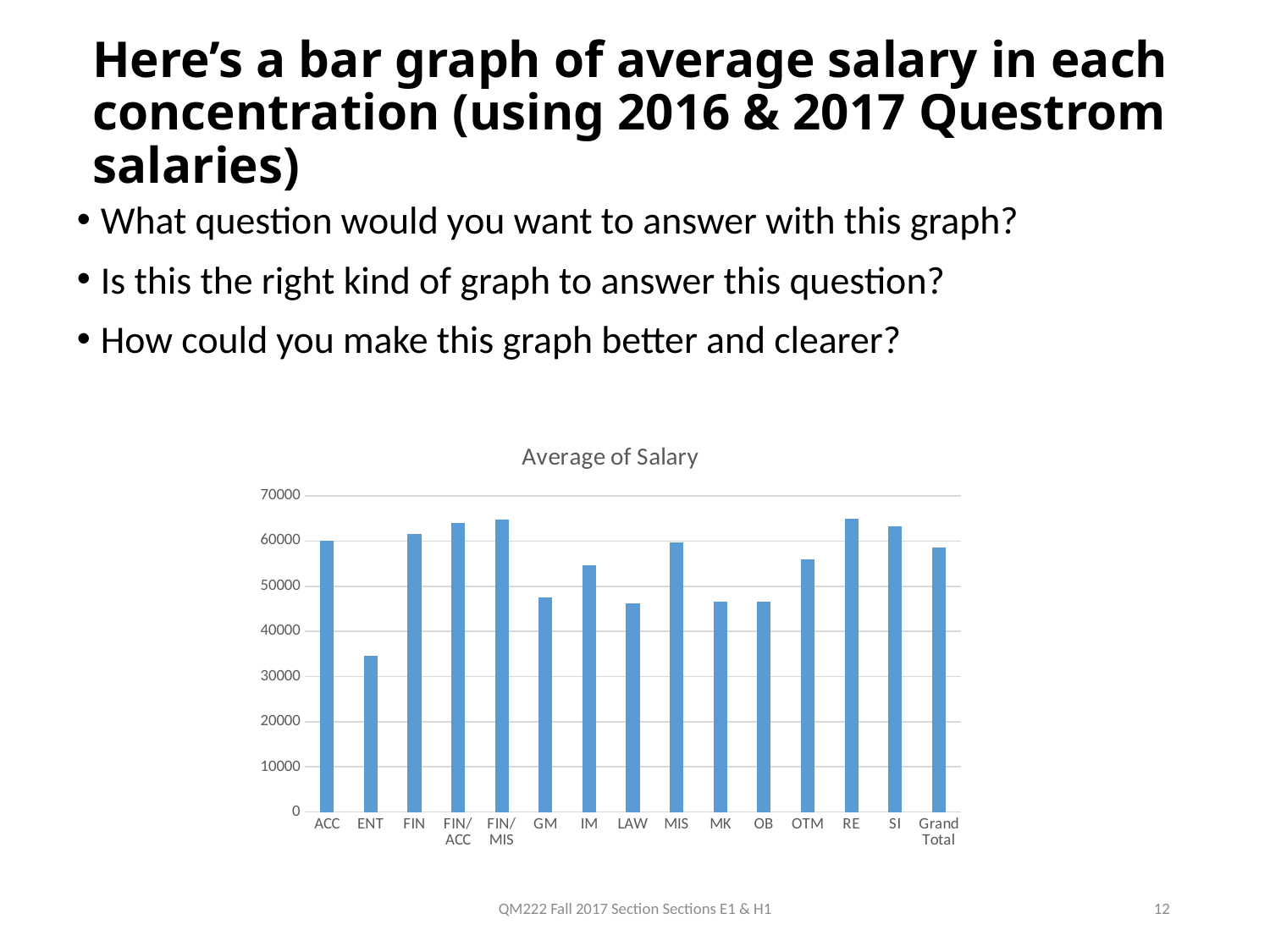
Which has a higher average salary, FIN or GM? FIN Is the value for RE greater or less than 60000? greater What kind of chart is shown on the slide? bar chart What is the title of the chart? Average of Salary Which has a higher average salary, ENT or LAW? LAW Is the value for GM greater or less than 50000? less Which category has the lowest average salary? ENT Is the value for IM greater or less than 50000? greater How many categories are shown on the x axis of the chart? 15